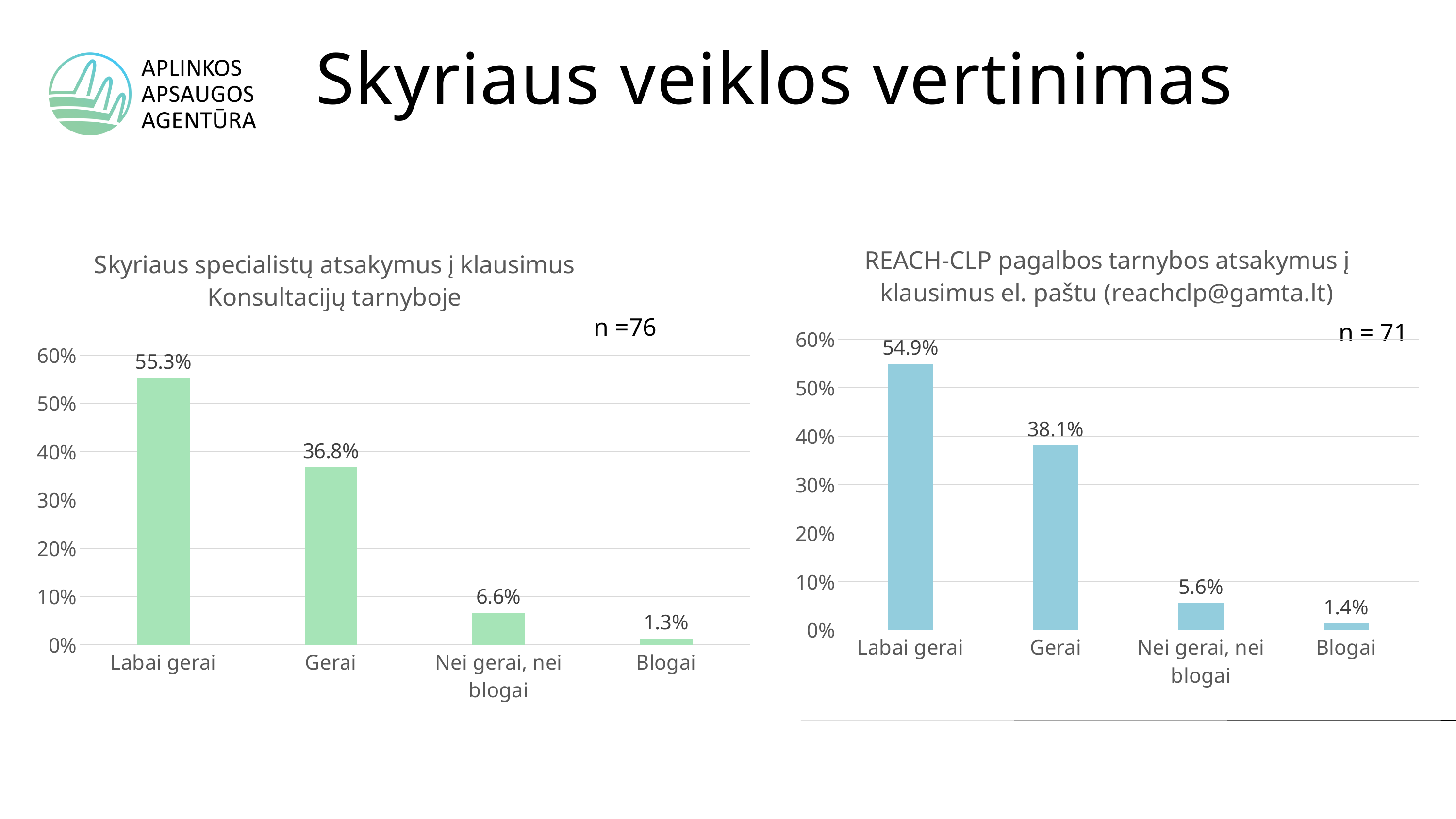
In the right chart (REACH-CLP pagalbos tarnybos atsakymus į klausimus el. paštu), what is the difference between Nei gerai, nei blogai and Blogai? 4.2% In the left chart (Skyriaus specialistų atsakymus į klausimus Konsultacijų tarnyboje), what is the value for Nei gerai, nei blogai? 6.6% In the left chart (Skyriaus specialistų atsakymus į klausimus Konsultacijų tarnyboje), what is the value for Labai gerai? 55.3% How many categories does the right chart (REACH-CLP pagalbos tarnybos atsakymus į klausimus el. paštu) show? 4 In the right chart (REACH-CLP pagalbos tarnybos atsakymus į klausimus el. paštu), what is the value for Blogai? 1.4% What kind of chart is the left chart (Skyriaus specialistų atsakymus į klausimus Konsultacijų tarnyboje)? Bar chart In the right chart (REACH-CLP pagalbos tarnybos atsakymus į klausimus el. paštu), what is the value for Gerai? 38.1% In the right chart (REACH-CLP pagalbos tarnybos atsakymus į klausimus el. paštu), which category has the lowest value? Blogai What is the sample size (n) shown for the right chart (REACH-CLP pagalbos tarnybos atsakymus į klausimus el. paštu)? 71 In the left chart (Skyriaus specialistų atsakymus į klausimus Konsultacijų tarnyboje), which category has the highest value? Labai gerai Which is larger: Gerai in the left chart or Gerai in the right chart? Gerai in the right chart In the left chart (Skyriaus specialistų atsakymus į klausimus Konsultacijų tarnyboje), what is the difference between Labai gerai and Gerai? 18.5%